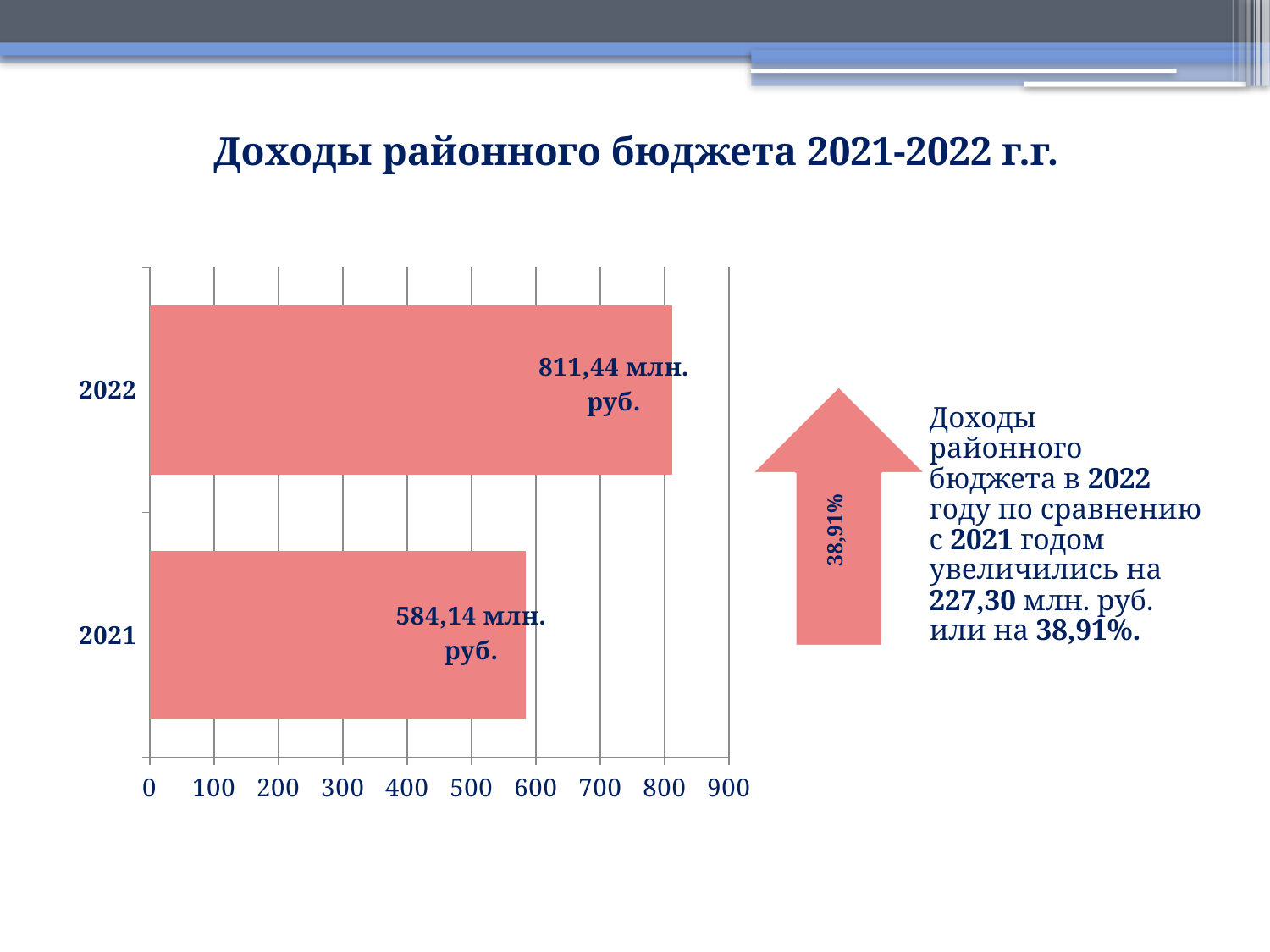
What is the title of the slide? Доходы районного бюджета 2021-2022 г.г. Is the value for 2022 greater or less than 800? greater How many categories (years) are shown in the chart? 2 Is the value for 2022 larger than the value for 2021? Yes What is the difference between the 2022 and 2021 values? 227,30 млн. руб. What kind of chart is shown on the slide? Bar chart Which year has the higher value? 2022 What is the value for 2021? 584,14 млн. руб. What is the value for 2022? 811,44 млн. руб. What percentage increase is shown on the arrow next to the chart? 38,91% Is the value for 2021 greater or less than 600? less Which year has the lower value? 2021